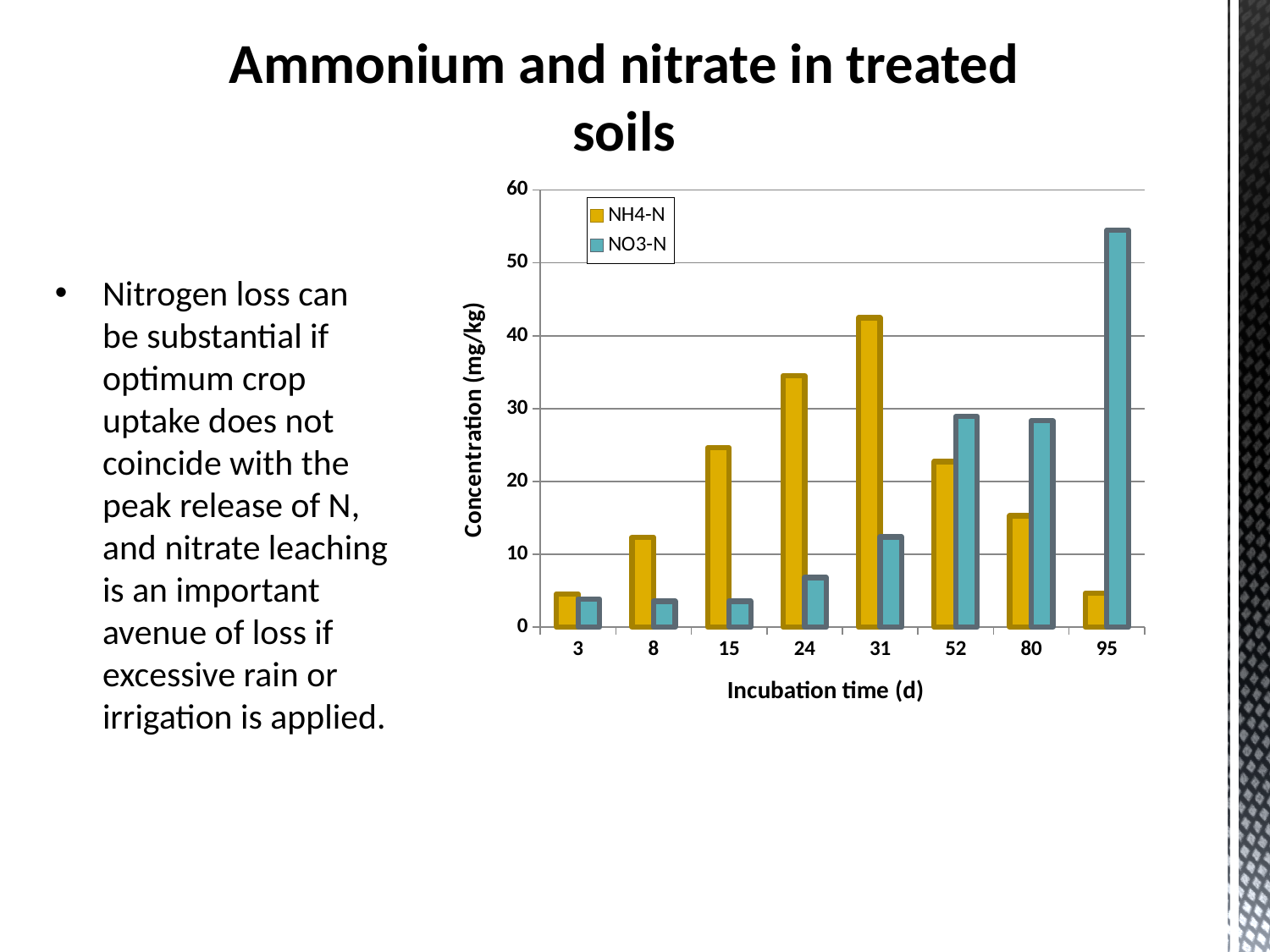
How many incubation time categories are shown on the x axis? 8 What kind of chart is shown on the slide? bar chart At incubation time 52, which series has the larger value, NH4-N or NO3-N? NO3-N Is the NH4-N value at incubation time 31 greater or less than 40? greater At which incubation time is the NO3-N concentration highest? 95 How many series does the legend list? 2 Is the NH4-N value at incubation time 80 greater or less than 20? less What is the label of the y axis? Concentration (mg/kg) At incubation time 15, which series has the larger value, NH4-N or NO3-N? NH4-N At which incubation time is the NH4-N concentration highest? 31 Is the NO3-N value at incubation time 24 greater or less than 10? less